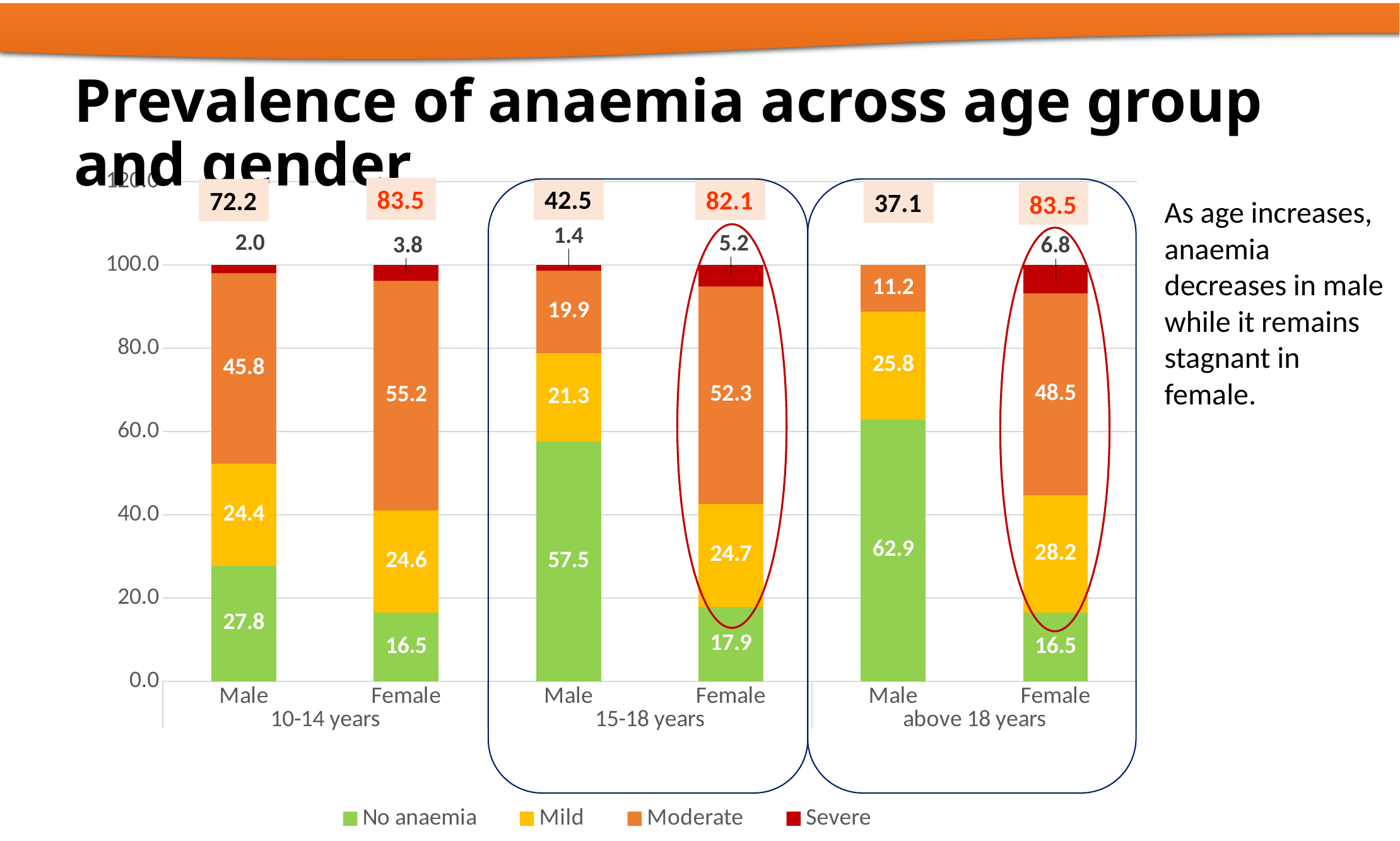
Which bar has the highest Moderate value? Female, 10-14 years What is the Severe value for Female in the 15-18 years group? 5.2 How many bars are plotted in the chart? 6 What is the Moderate value for Female in the above 18 years group? 48.5 Which bar has the highest No anaemia value? Male, above 18 years What is the No anaemia value for Male in the 15-18 years group? 57.5 What is the Mild value for Male in the 10-14 years group? 24.4 How many series does the legend list? 4 What is the difference between the Moderate values for Female and Male in the 10-14 years group? 9.4 What kind of chart is shown on the slide? Stacked bar chart Which colour represents the Mild series in the legend? Yellow Which is larger, the Mild value for Female in the above 18 years group or the Mild value for Female in the 15-18 years group? Female, above 18 years